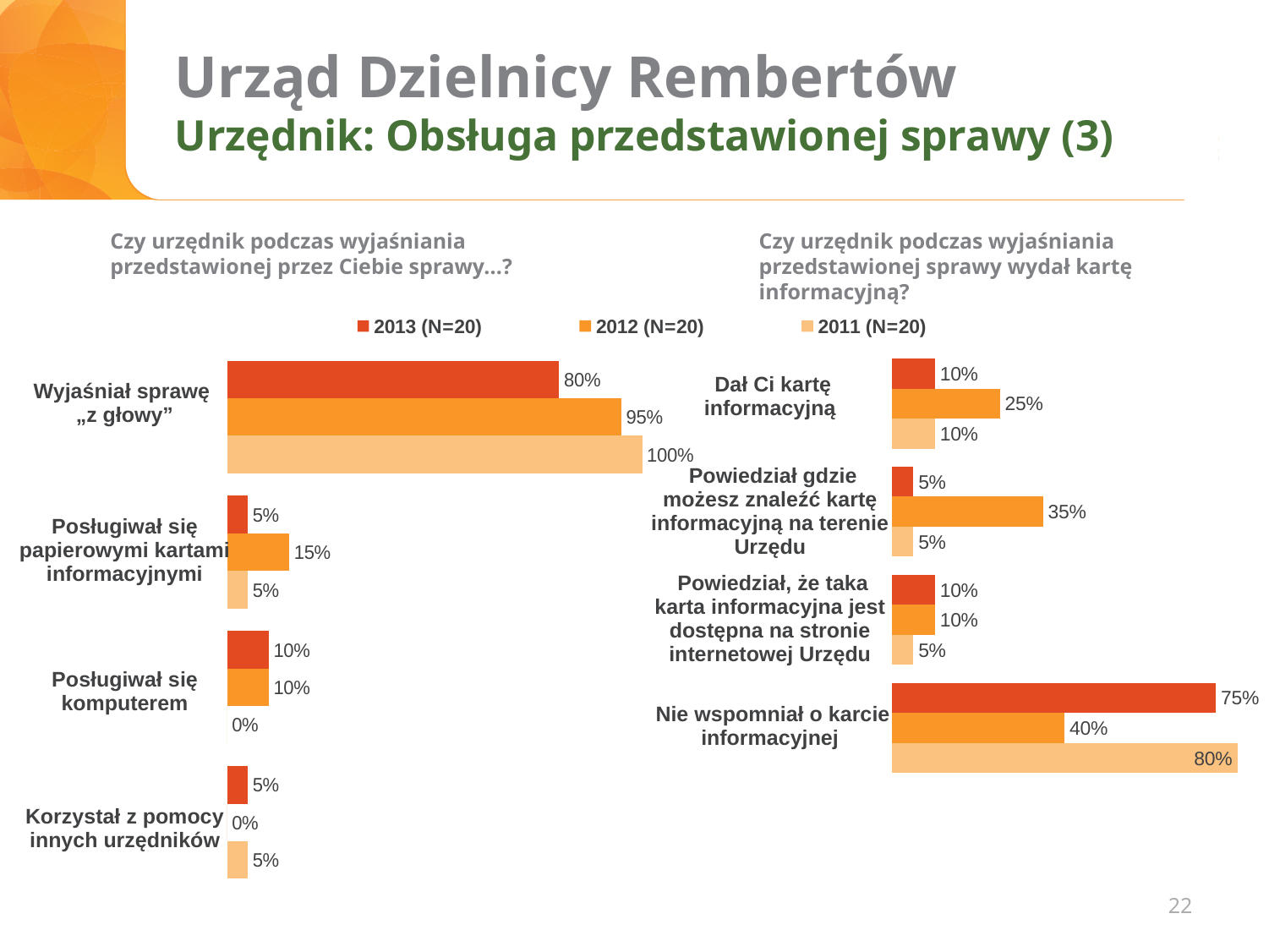
In the left chart, what is the 2011 value for "Posługiwał się komputerem"? 0% In the right chart, which category has the highest 2013 value? Nie wspomniał o karcie informacyjnej In the right chart, what is the 2012 value for "Powiedział gdzie możesz znaleźć kartę informacyjną na terenie Urzędu"? 35% How many series does the legend list? 3 In the right chart, which is larger for "Nie wspomniał o karcie informacyjnej": the 2013 value or the 2012 value? 2013 In the left chart, what is the 2012 value for "Posługiwał się papierowymi kartami informacyjnymi"? 15% In the left chart, what is the 2011 value for "Wyjaśniał sprawę „z głowy”"? 100% In the right chart ("Czy urzędnik podczas wyjaśniania przedstawionej sprawy wydał kartę informacyjną?"), what is the 2012 value for "Dał Ci kartę informacyjną"? 25% In the left chart, what is the difference between the 2012 and 2013 values for "Wyjaśniał sprawę „z głowy”"? 15% In the right chart, what is the difference between the 2011 and 2012 values for "Nie wspomniał o karcie informacyjnej"? 40% What kind of chart is the left chart? Bar chart In the left chart ("Czy urzędnik podczas wyjaśniania przedstawionej przez Ciebie sprawy...?"), what is the 2013 value for "Wyjaśniał sprawę „z głowy”"? 80%